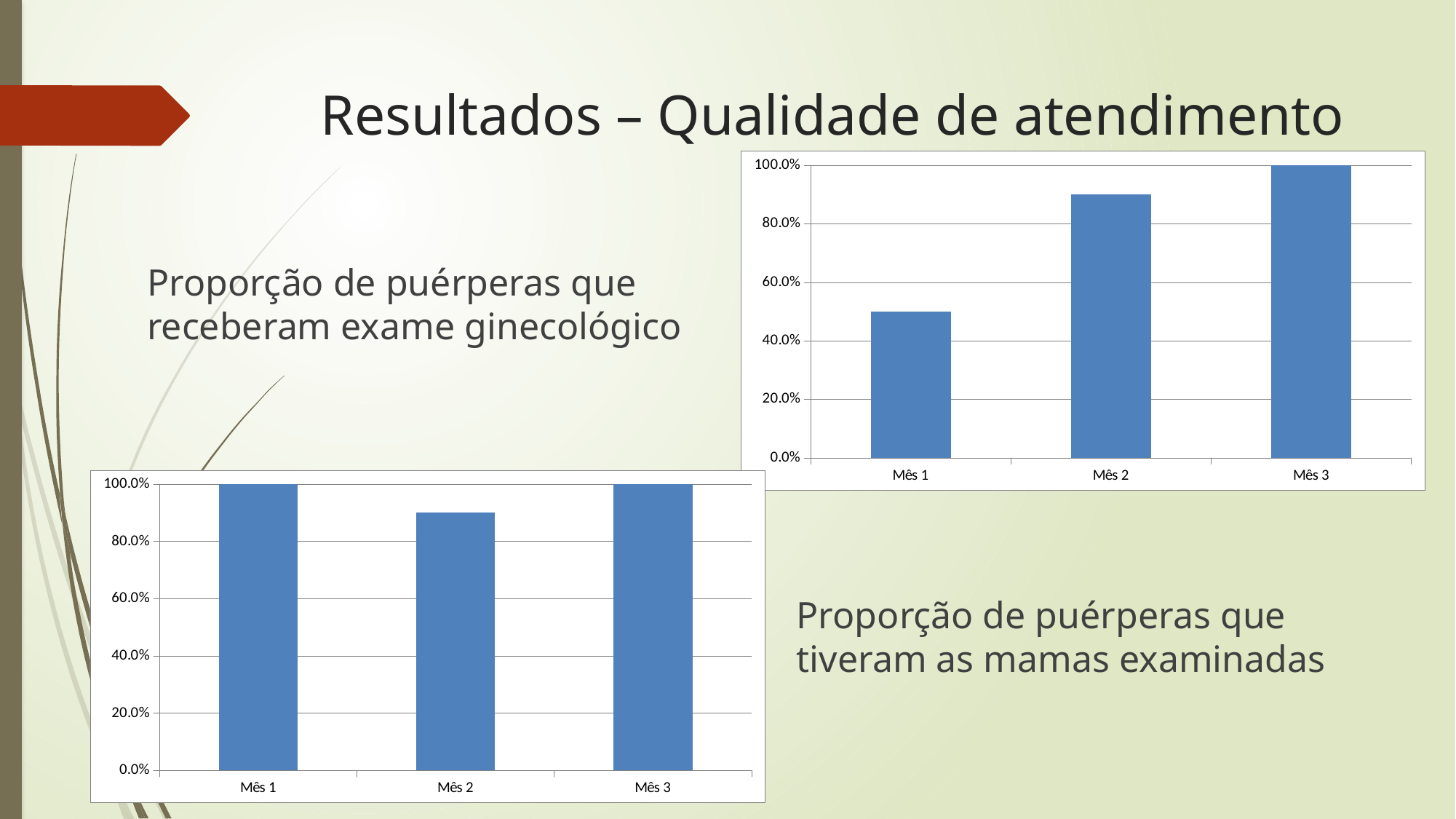
In the bottom-left chart (mamas examinadas), which is larger, the value for Mês 1 or Mês 2? Mês 1 In the top-right chart (exame ginecológico), which is larger, the value for Mês 1 or Mês 2? Mês 2 How many months are shown on the x axis of the top-right chart (exame ginecológico)? 3 In the top-right chart (exame ginecológico), what is the value for Mês 3? 100.0% In the top-right chart (exame ginecológico), is the value for Mês 2 greater or less than 80.0%? greater In the top-right chart (exame ginecológico), is the value for Mês 1 greater or less than 60.0%? less In the bottom-left chart (mamas examinadas), is the value for Mês 2 greater or less than 80.0%? greater In the top-right chart (exame ginecológico), do the values rise or fall from Mês 1 to Mês 3? rise In the top-right chart (exame ginecológico), which month has the highest value? Mês 3 In the bottom-left chart (mamas examinadas), which month has the lowest value? Mês 2 In the bottom-left chart (mamas examinadas), what is the value for Mês 1? 100.0% In the top-right chart (exame ginecológico), which month has the lowest value? Mês 1